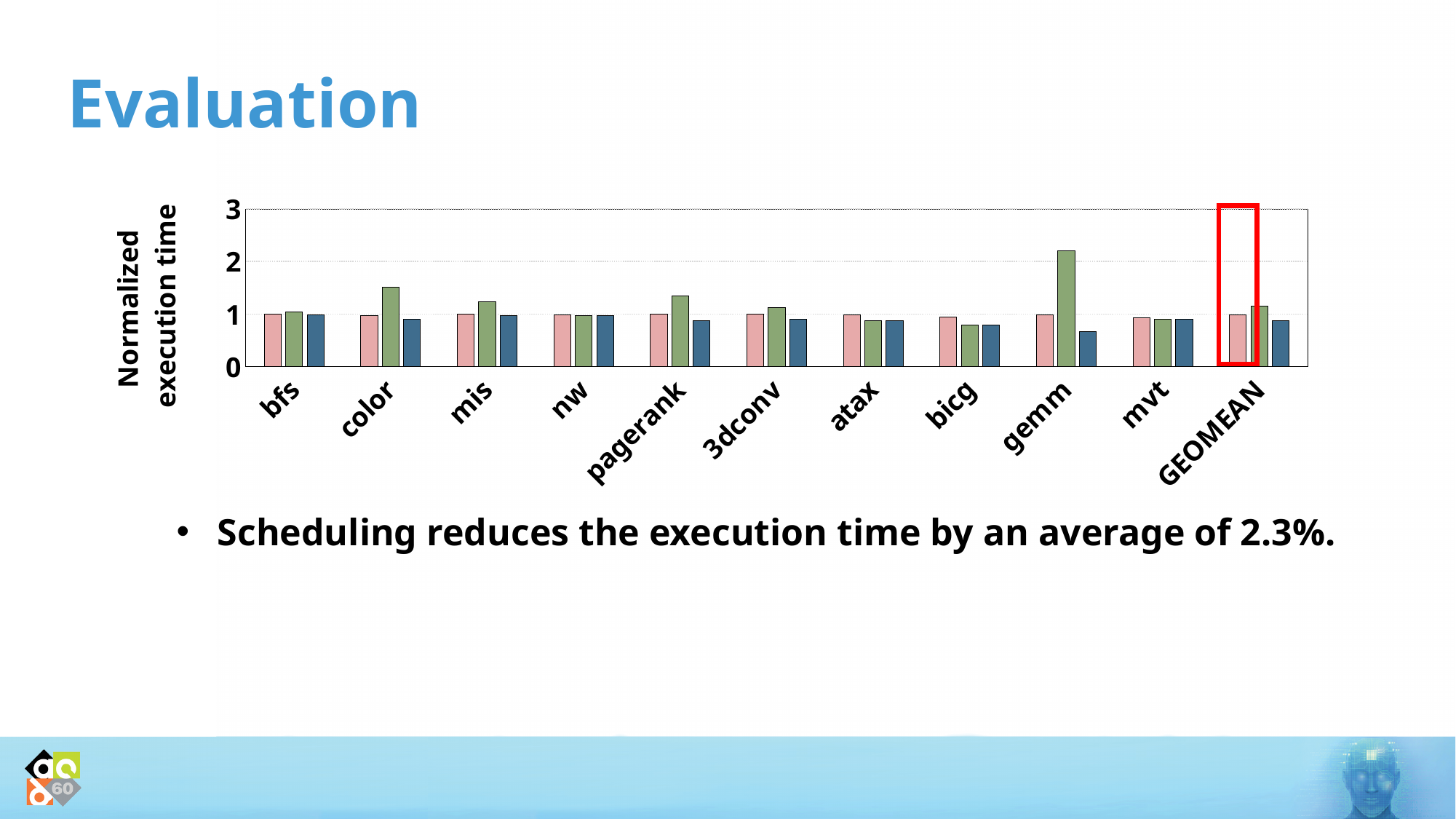
Which category is highlighted with a red box in the chart? GEOMEAN Which category has the tallest green bar in the chart? gemm What is the label of the y axis of the chart? Normalized execution time Is the blue bar for gemm greater or less than 1? less What kind of chart is shown on the slide? bar chart Which is larger, the green bar for gemm or the green bar for color? gemm How many bars are plotted for each category in the chart? 3 Is the green bar for pagerank greater or less than 1? greater How many categories are shown along the x axis of the chart? 11 Is the green bar for gemm greater or less than 2? greater Which is larger, the green bar for color or the green bar for mis? color